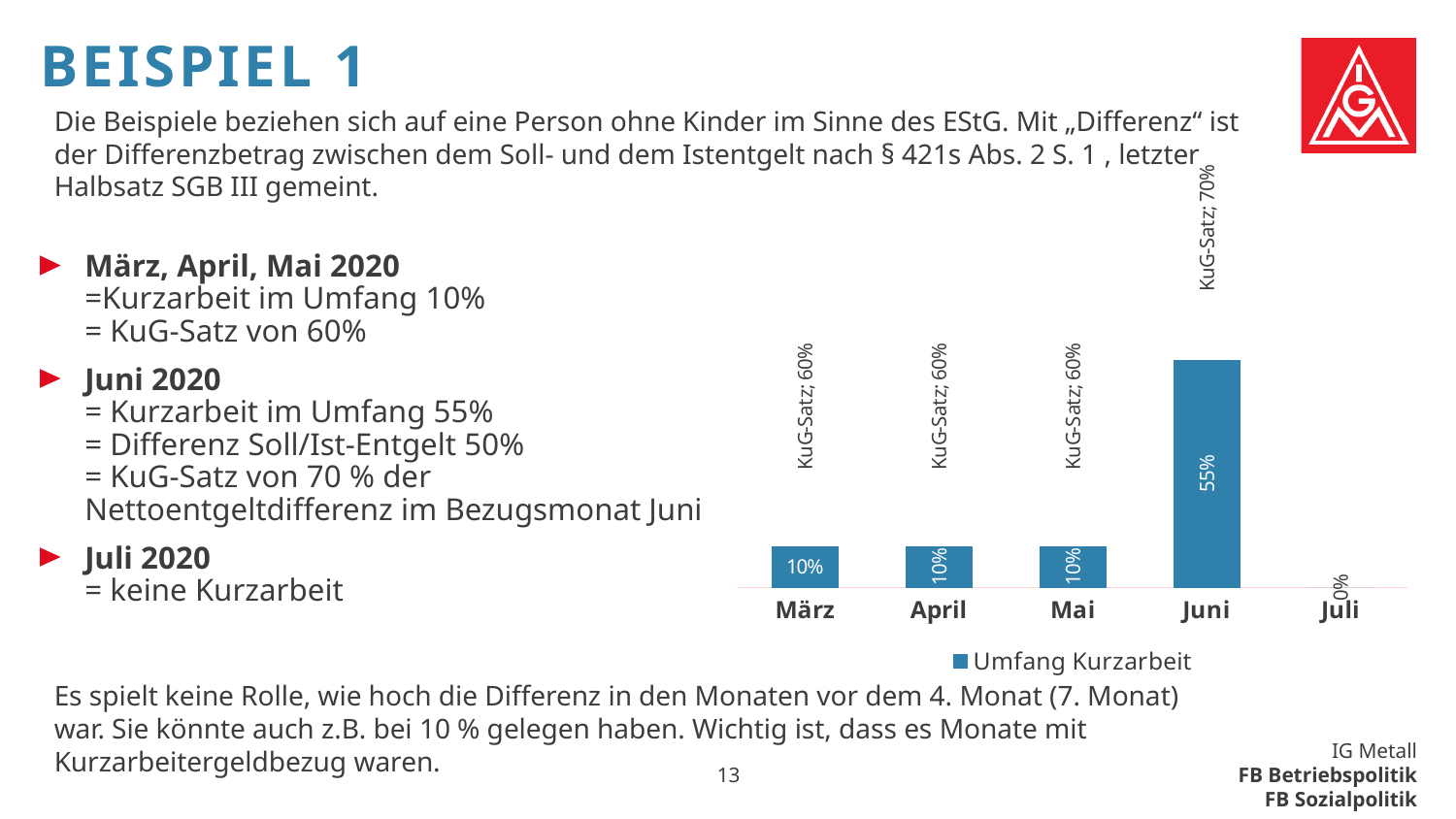
What kind of chart is shown on the slide? bar chart What is the value for März in the chart? 10% What is the name of the series in the chart legend? Umfang Kurzarbeit What is the value for Juli in the chart? 0% How many series does the chart legend list? 1 How many months are shown on the x axis of the chart? 5 Which month has the highest value in the chart? Juni Which is larger, the value for April or the value for Juni? Juni What is the value for Juni in the chart? 55% Which month has the lowest value in the chart? Juli What is the difference between the values for Juni and Mai? 45% What KuG-Satz is labelled above the bar for Juni? KuG-Satz; 70%